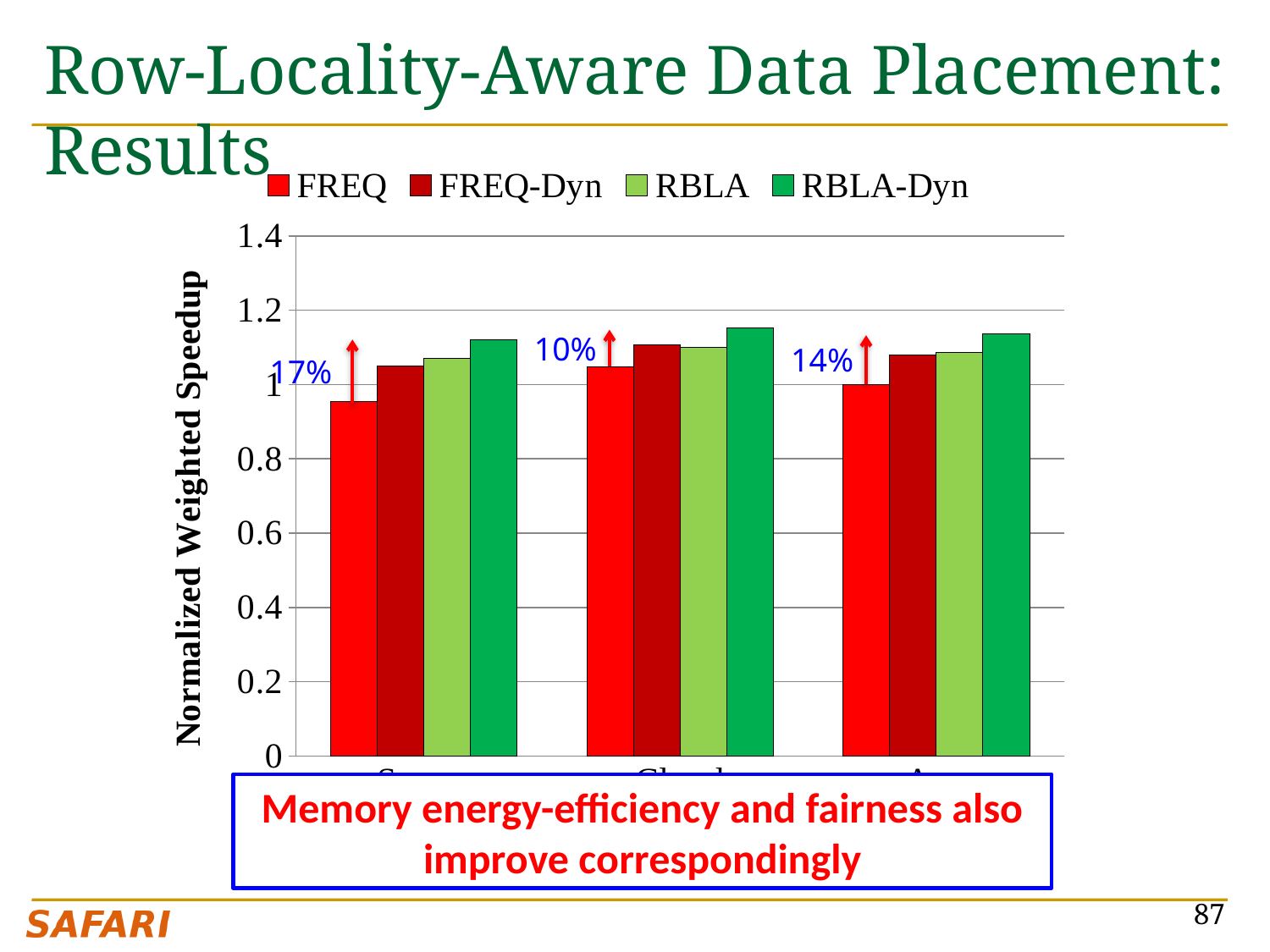
In the first (leftmost) group of bars, which series has the lowest value? FREQ In the first (leftmost) group of bars, is the RBLA-Dyn value greater or less than 1? greater In the third (rightmost) group of bars, which is larger, the FREQ value or the RBLA-Dyn value? RBLA-Dyn In the second (middle) group of bars, is the FREQ value greater or less than 1? greater What percentage improvement is annotated above the first (leftmost) group of bars? 17% How many groups of bars are plotted along the x axis? 3 What kind of chart is shown on the slide? bar chart In the first (leftmost) group of bars, is the FREQ value greater or less than 1? less In the first (leftmost) group of bars, which series has the highest value? RBLA-Dyn What is the label of the y axis? Normalized Weighted Speedup How many series does the legend list? 4